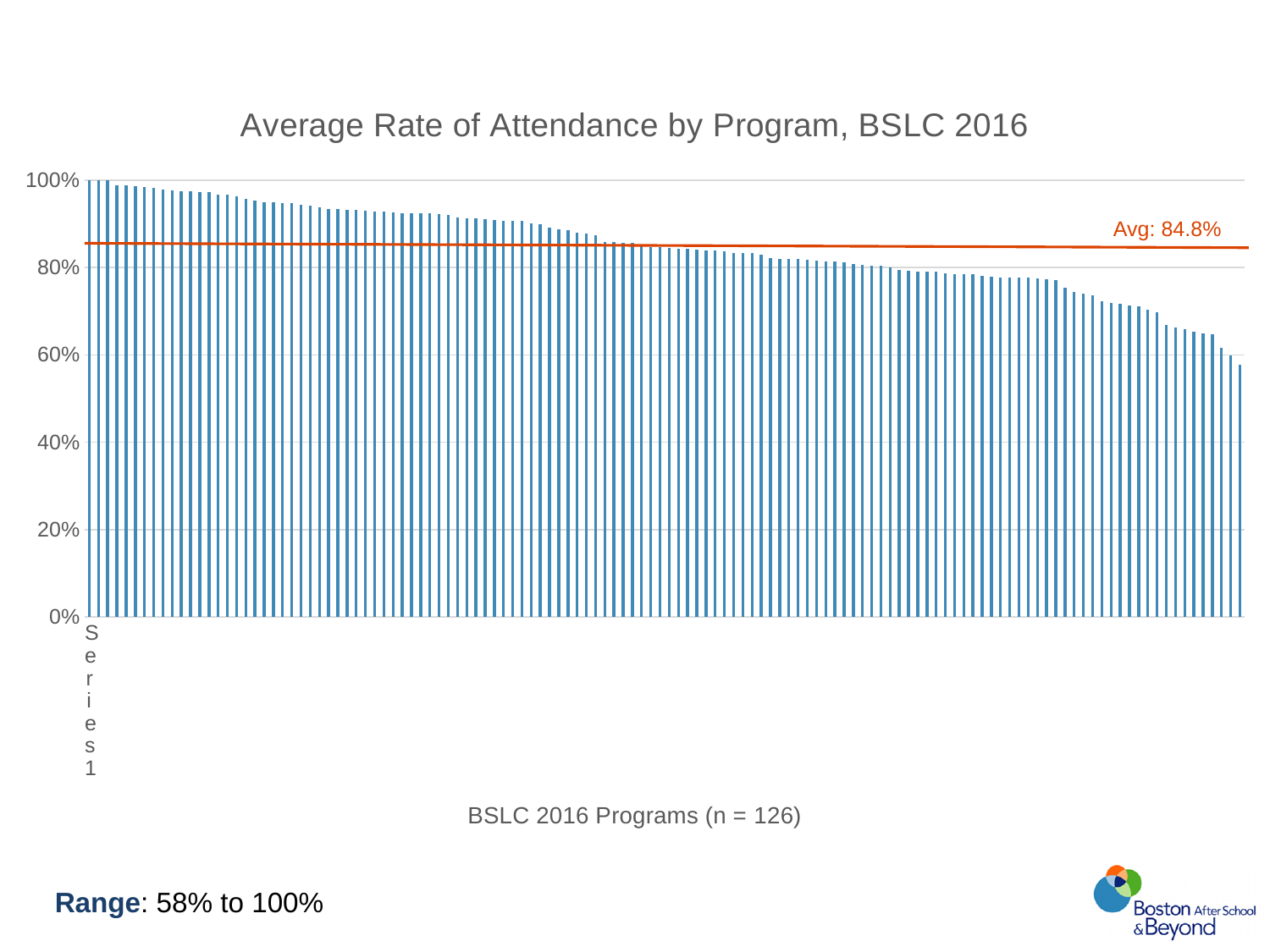
Is the value of the leftmost bar greater or less than 80%? greater Is the average line (84.8%) above or below the 80% gridline? above What is the lowest attendance rate shown, according to the range stated on the slide? 58% Is the value of the rightmost bar greater or less than 60%? less What is the label on the x axis of the chart? BSLC 2016 Programs (n = 126) What is the highest attendance rate shown, according to the range stated on the slide? 100% What kind of chart is shown on the slide? Bar chart How many programs are plotted in the chart, according to the x-axis label? 126 What average value is marked by the horizontal line on the chart? 84.8% What is the title of the chart? Average Rate of Attendance by Program, BSLC 2016 Do the bar values rise or fall from left to right along the x axis? Fall What is the difference between the highest and lowest attendance rates in the stated range? 42 percentage points